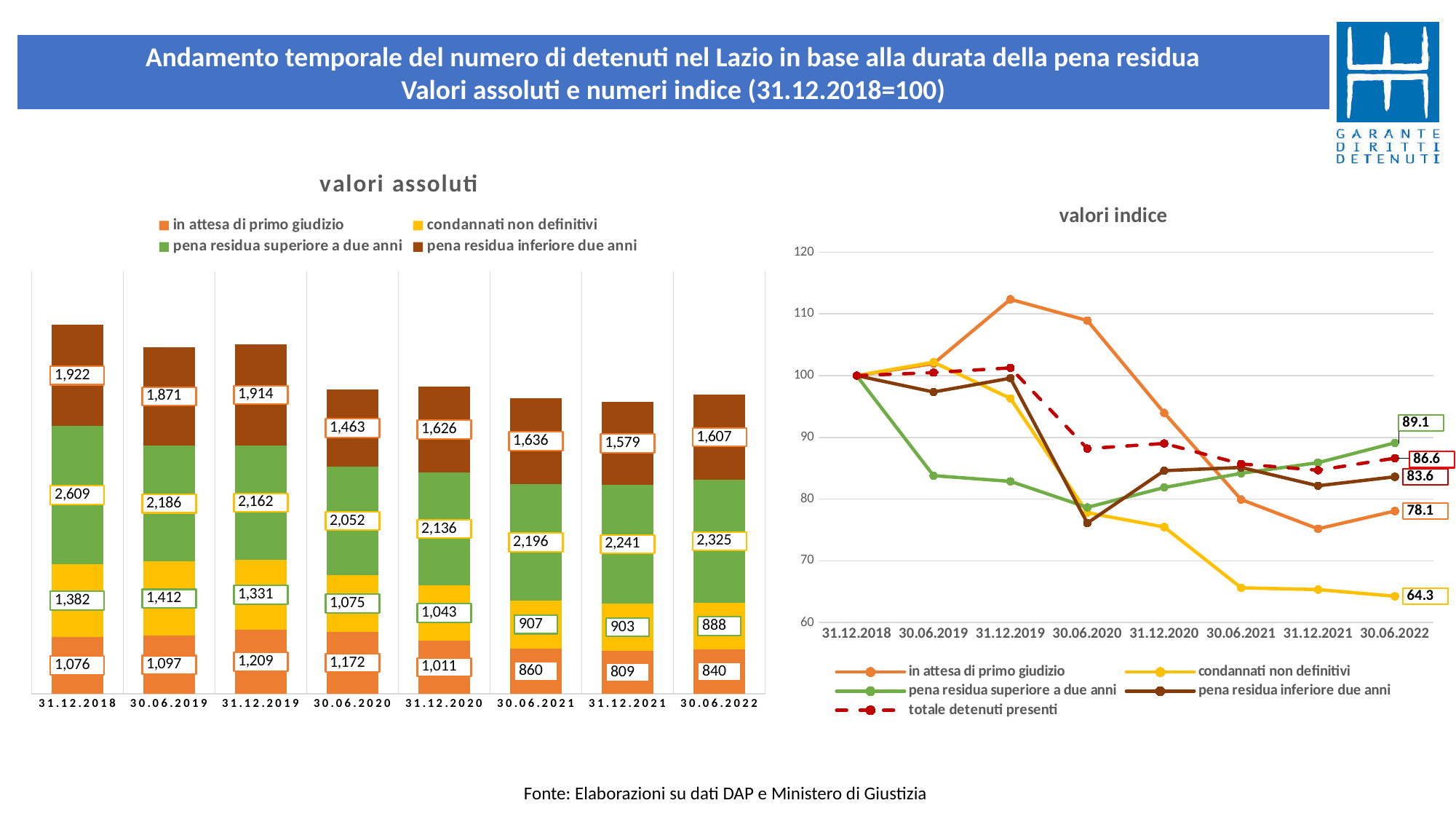
In the 'valori assoluti' chart, which is larger: 'condannati non definitivi' at 31.12.2018 or at 30.06.2019? 30.06.2019 In the 'valori assoluti' chart, what is the value for 'in attesa di primo giudizio' at 31.12.2019? 1,209 In the 'valori indice' chart, what is the value for 'condannati non definitivi' at 30.06.2022? 64.3 How many dates are shown on the x axis of the 'valori assoluti' chart? 8 In the 'valori indice' chart, is the value for 'in attesa di primo giudizio' at 31.12.2019 greater or less than 110? greater What kind of chart is the 'valori indice' chart? line chart In the 'valori assoluti' chart, at which date is 'in attesa di primo giudizio' lowest? 31.12.2021 In the 'valori assoluti' chart, what is the total of the stacked bar for 31.12.2018? 6,989 In the 'valori assoluti' chart, at which date is 'pena residua superiore a due anni' highest? 31.12.2018 In the 'valori assoluti' chart, what is the difference between 'pena residua inferiore due anni' at 31.12.2018 and at 30.06.2022? 315 How many series does the legend of the 'valori indice' chart list? 5 In the 'valori assoluti' chart, what is the value for 'pena residua superiore a due anni' at 30.06.2022? 2,325